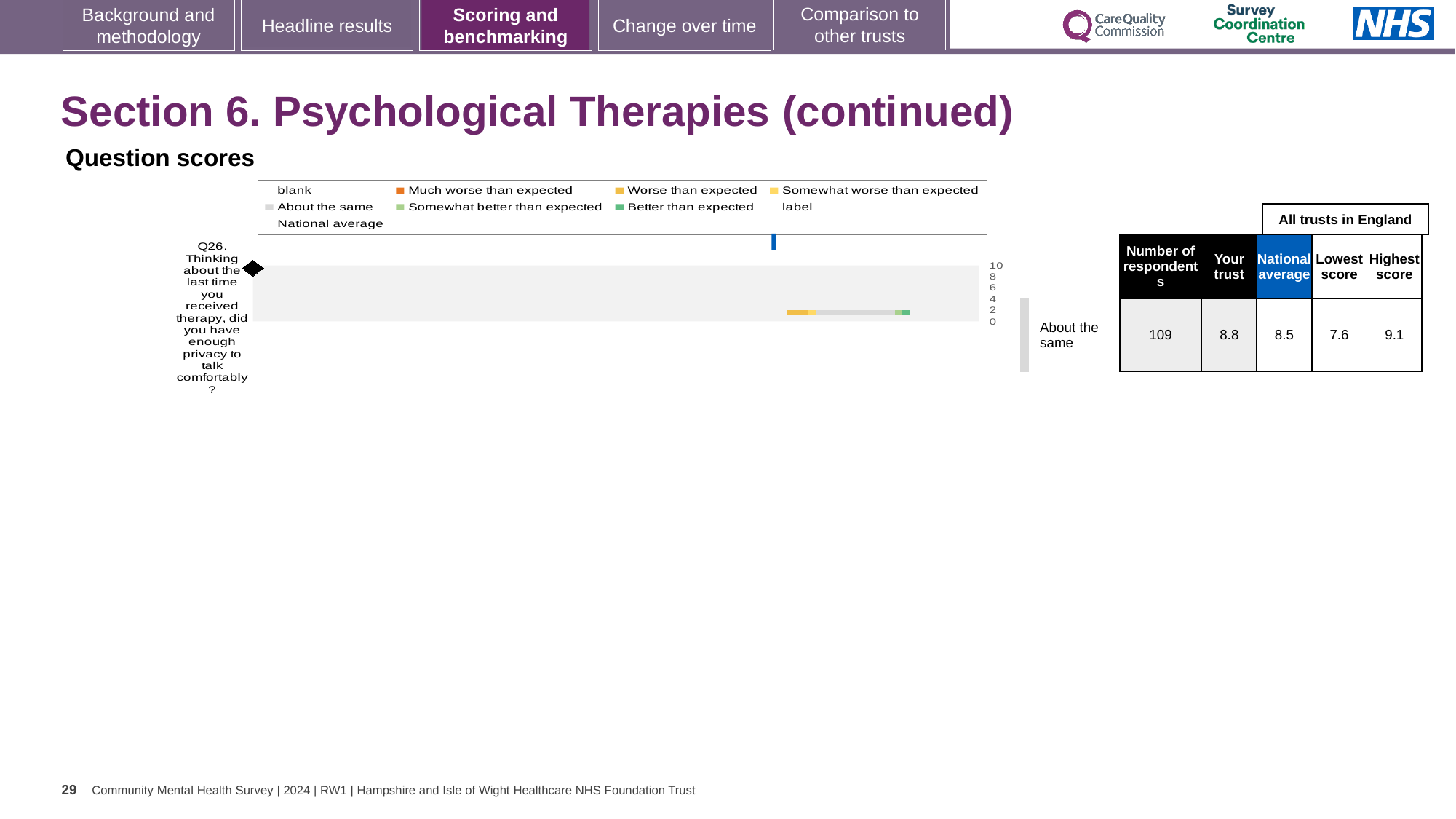
Which question is plotted in the Question scores chart? Q26. Thinking about the last time you received therapy, did you have enough privacy to talk comfortably? What is the highest tick value on the score axis of the Question scores chart? 10 What is the difference between the highest and lowest scores among all trusts in England for Q26? 1.5 How many questions are plotted in the Question scores chart? 1 What is the difference between the 'Your trust' score and the national average for Q26? 0.3 What is the highest score among all trusts in England for Q26? 9.1 What is the 'Your trust' score for Q26? 8.8 Which is larger for Q26, the 'Your trust' score or the national average? Your trust What is the lowest score among all trusts in England for Q26? 7.6 What is the national average score for Q26? 8.5 How many respondents answered Q26? 109 What kind of chart is shown under 'Question scores'? Bar chart